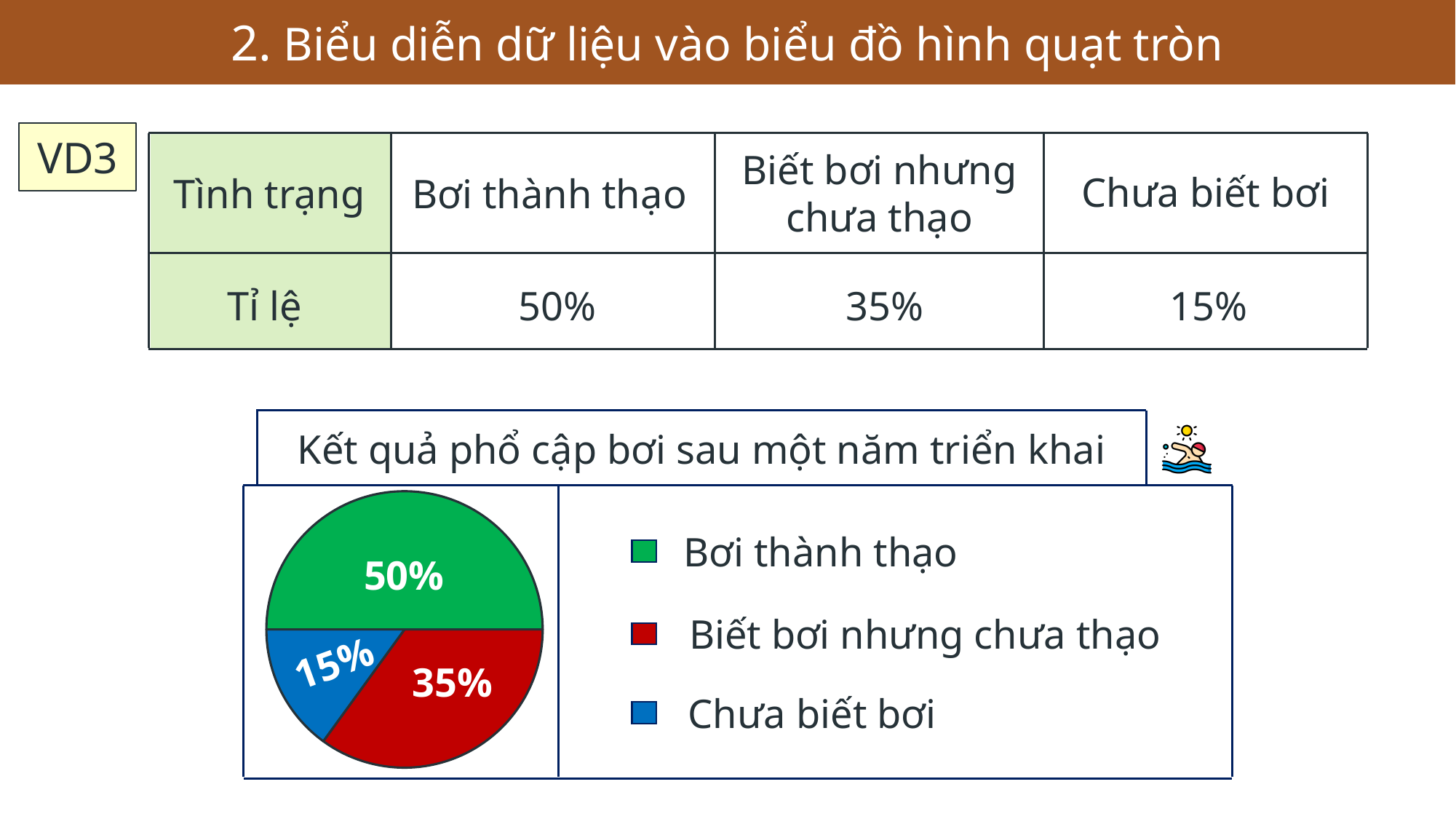
What is the difference between the Bơi thành thạo slice and the Chưa biết bơi slice? 35% What share of the pie does the Biết bơi nhưng chưa thạo slice represent? 35% What is the title of the pie chart? Kết quả phổ cập bơi sau một năm triển khai How many slices does the pie chart have? 3 Which category has the smallest slice in the pie chart? Chưa biết bơi What percentage does the pie chart show for Chưa biết bơi? 15% What percentage does the pie chart show for Biết bơi nhưng chưa thạo? 35% What kind of chart is shown on the slide? pie chart Which category has the largest slice in the pie chart? Bơi thành thạo What percentage does the pie chart show for Bơi thành thạo? 50% Which is larger in the pie chart: Biết bơi nhưng chưa thạo or Chưa biết bơi? Biết bơi nhưng chưa thạo What colour is the Chưa biết bơi slice in the pie chart? blue